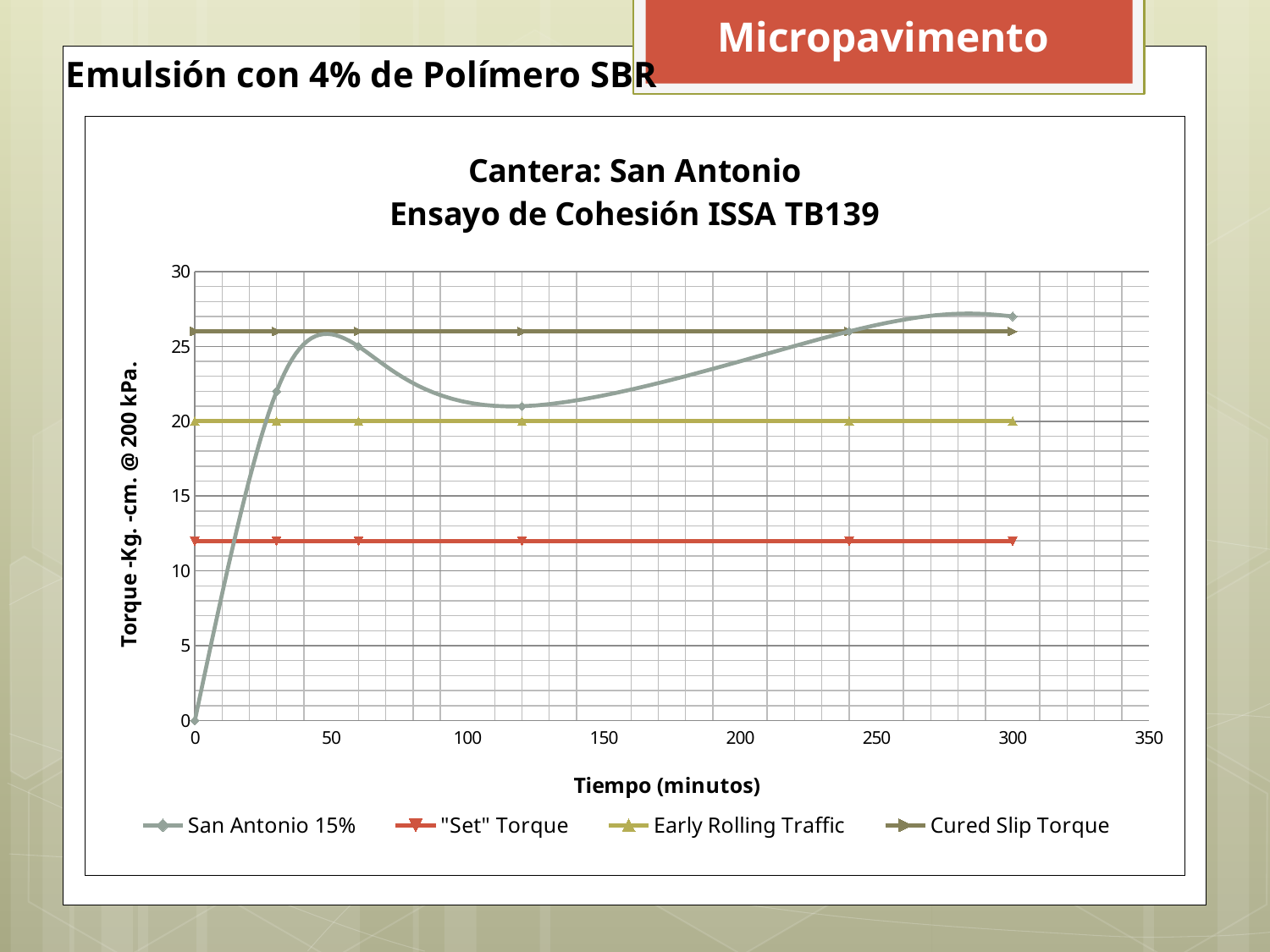
Is the value of the "Set" Torque series greater or less than 10? greater What is the title of the chart? Cantera: San Antonio Ensayo de Cohesión ISSA TB139 How many series does the legend list? 4 What is the label of the x axis? Tiempo (minutos) Is the value of the San Antonio 15% series at 120 minutes greater or less than 25? less What is the constant value of the Early Rolling Traffic series? 20 What is the value of the San Antonio 15% series at 0 minutes? 0 Is the value of the Cured Slip Torque series greater or less than 25? greater Which is larger, the "Set" Torque value or the Early Rolling Traffic value? Early Rolling Traffic Does the San Antonio 15% series rise or fall between 120 and 300 minutes? rise Which of the three horizontal reference series has the lowest value? "Set" Torque What kind of chart is shown on the slide? line chart